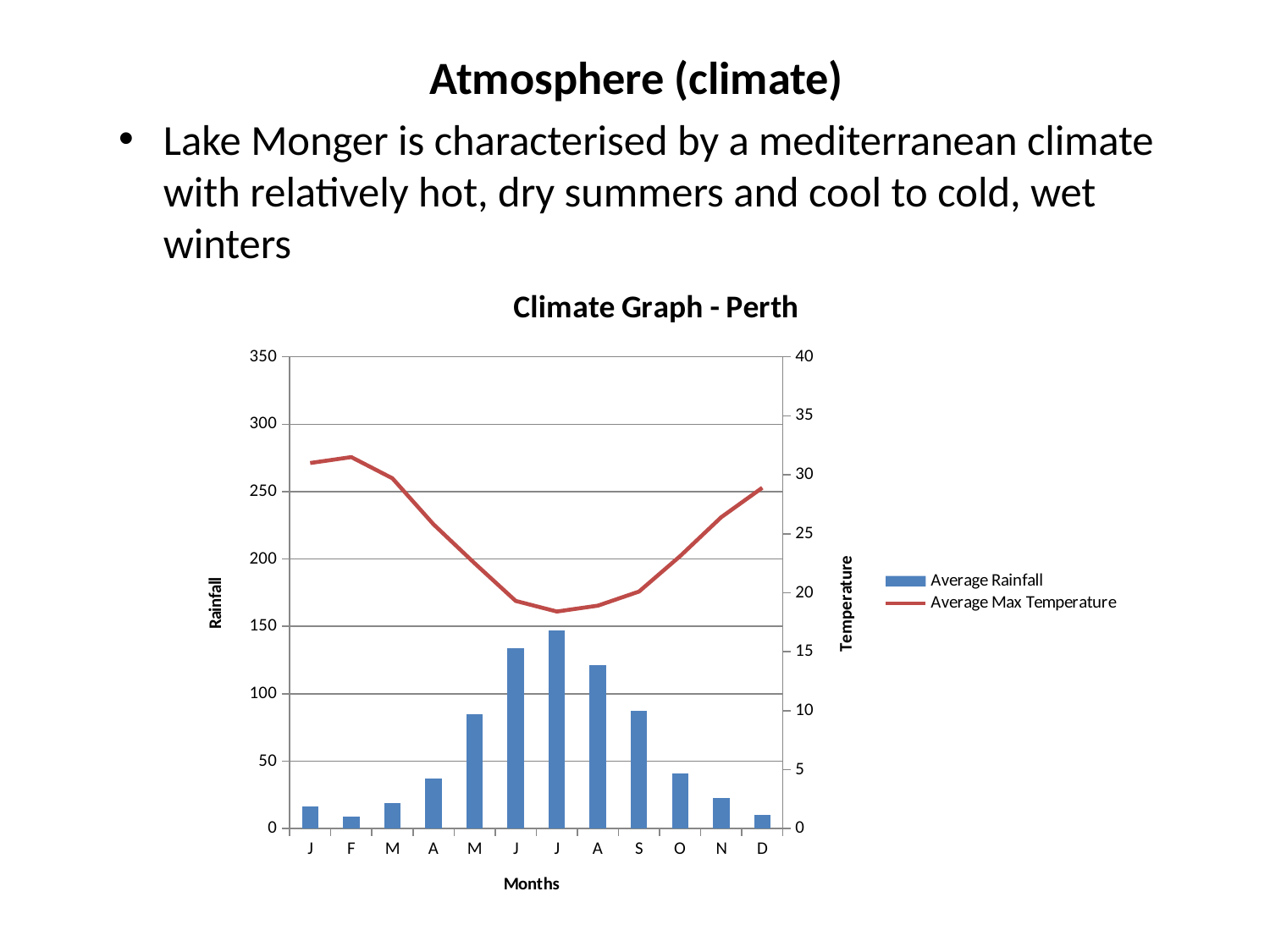
Is the Average Rainfall for the fifth month (May) greater or less than 100? less How many series does the legend list? 2 Is the Average Max Temperature for the first month (January) greater or less than 25? greater What is the title of the chart? Climate Graph - Perth Which month has the highest Average Rainfall bar? The seventh month (J, July) Is the Average Rainfall for the fourth month (April) greater or less than 50? less What kind of chart is shown on the slide? A combined bar and line chart Which has the higher Average Rainfall, the sixth month (June) or the ninth month (September)? June How many months are plotted along the x axis? 12 Does the Average Max Temperature line rise or fall from February to July? It falls